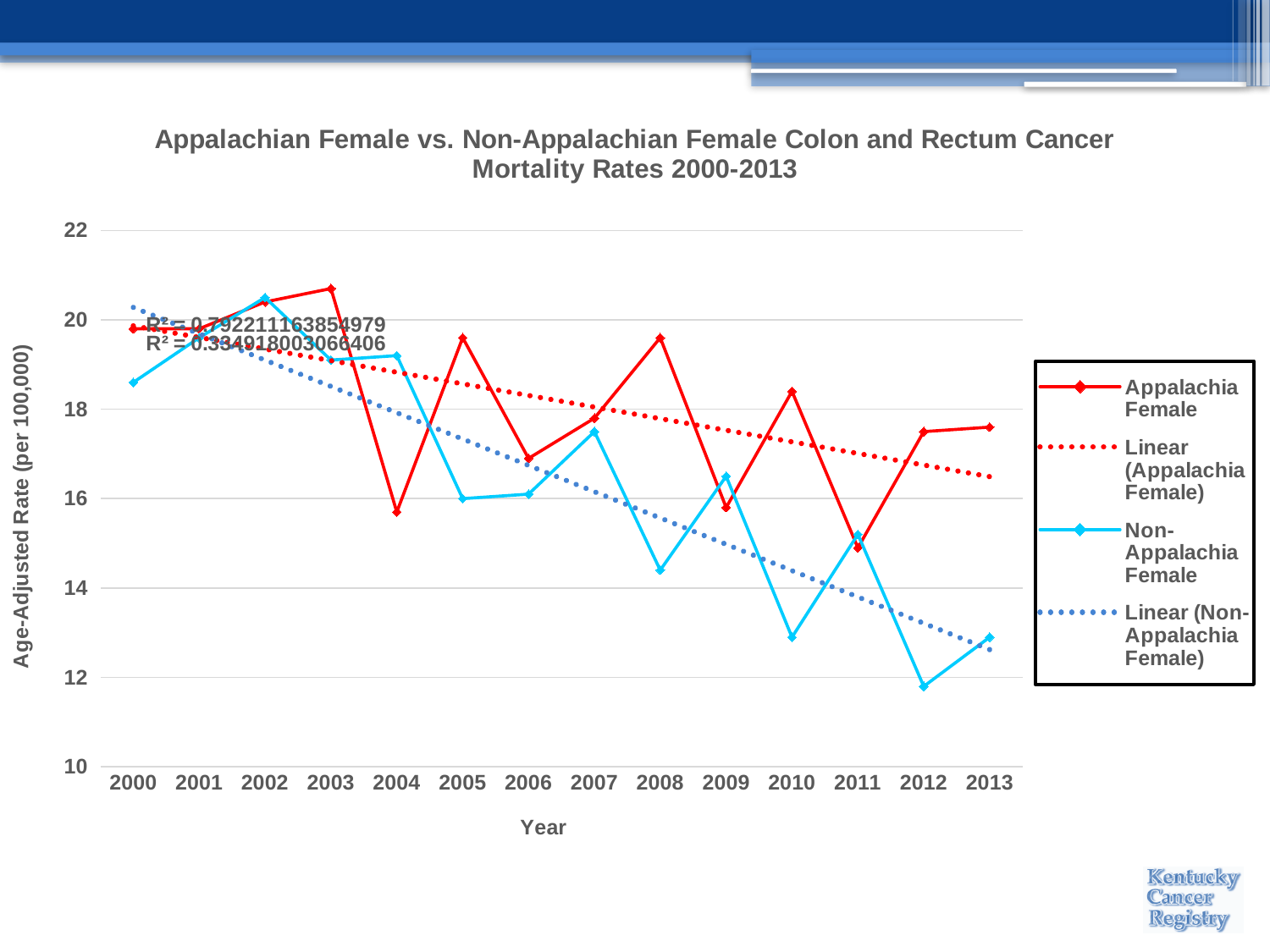
How many entries does the legend list? 4 What type of chart is shown on the slide? Line chart Is the Appalachia Female value for 2003 greater or less than 20? greater In 2008, which series has the higher mortality rate, Appalachia Female or Non-Appalachia Female? Appalachia Female Is the Non-Appalachia Female value for 2012 greater or less than 12? less In which year is the Non-Appalachia Female mortality rate lowest? 2012 Overall, do the Non-Appalachia Female mortality rates rise or fall from 2000 to 2013? Fall In which year is the Non-Appalachia Female mortality rate highest? 2002 In which year is the Appalachia Female mortality rate lowest? 2011 What is the label on the y axis? Age-Adjusted Rate (per 100,000) How many years are plotted along the x axis? 14 Is the Appalachia Female value for 2004 greater or less than 16? less